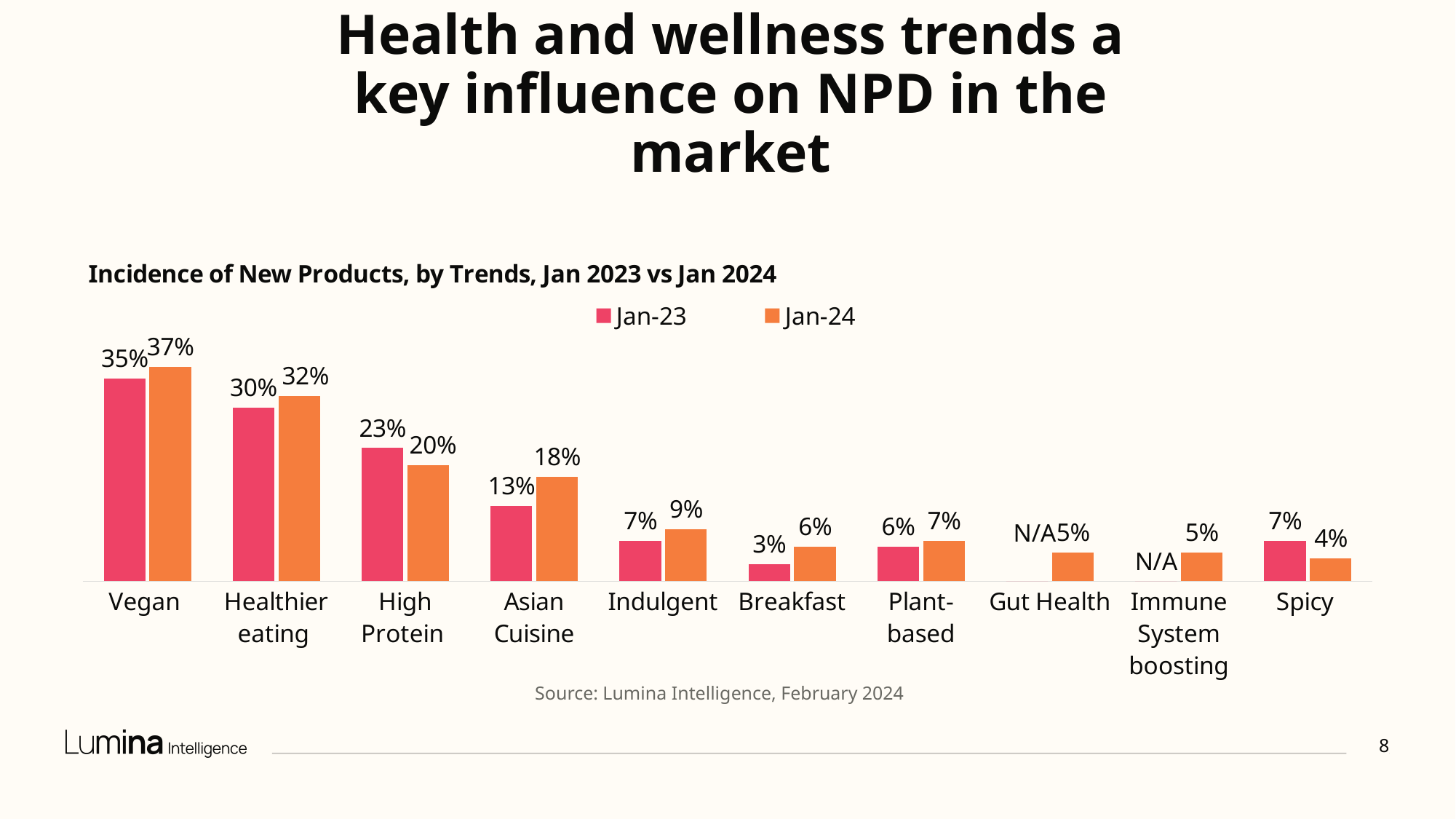
Which category has the highest Jan-24 value? Vegan What is the title of the chart? Incidence of New Products, by Trends, Jan 2023 vs Jan 2024 What is the Jan-23 value for High Protein? 23% Which is larger for Spicy, the Jan-23 value or the Jan-24 value? Jan-23 How many categories are shown on the x axis? 10 How many series does the legend list? 2 What kind of chart is shown on the slide? Bar chart What is the Jan-24 value for Vegan? 37% What is the difference between the Jan-24 and Jan-23 values for Asian Cuisine? 5% Which category has the lowest Jan-24 value? Spicy What is the Jan-24 value for Asian Cuisine? 18% What is the Jan-23 value for Breakfast? 3%